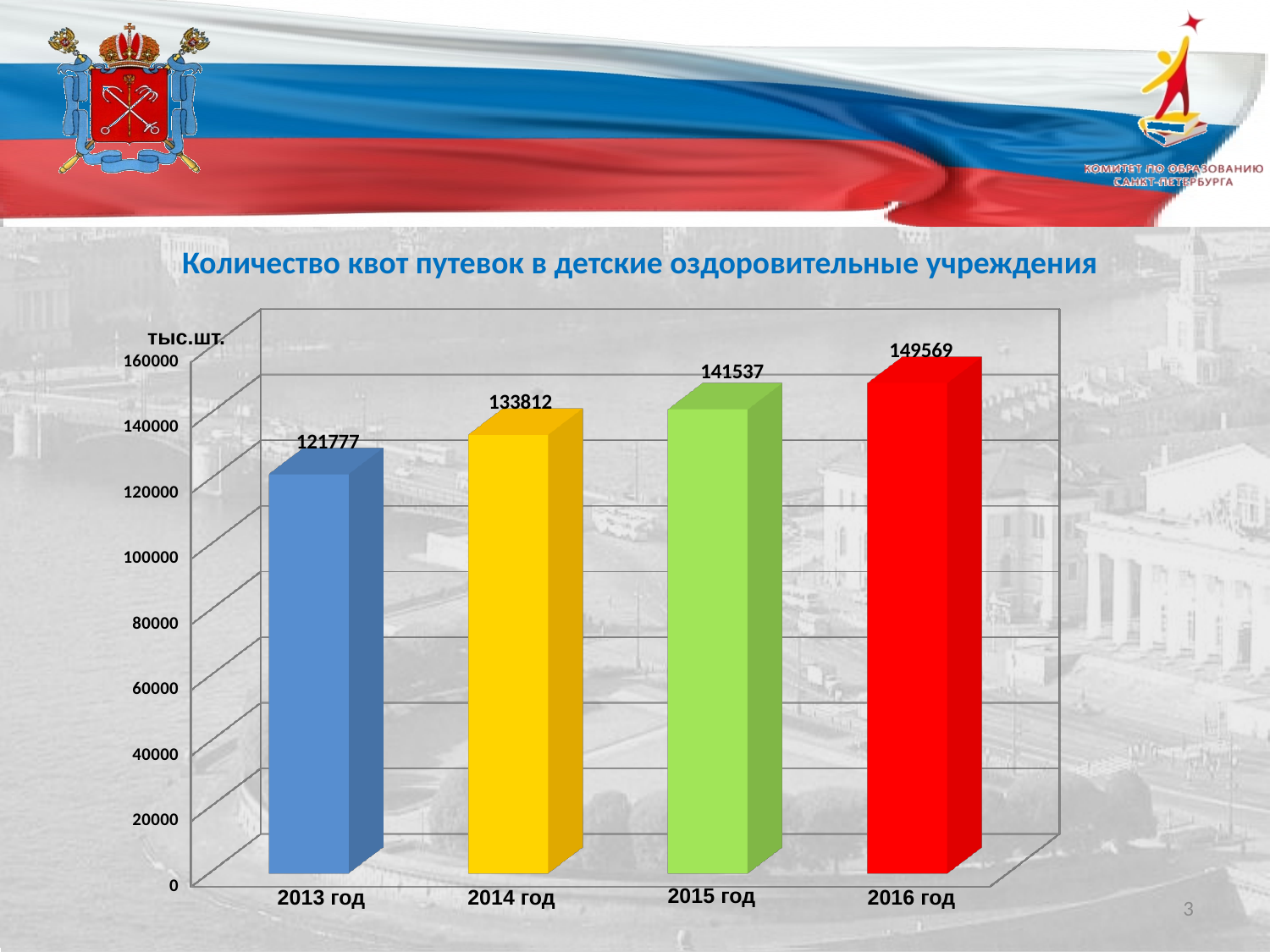
What is the value for 2013 год? 121777 Do the values rise or fall from 2013 год to 2016 год? rise What is the difference between the values for 2016 год and 2013 год? 27792 Which year has the lowest value? 2013 год Which is larger, the value for 2014 год or the value for 2015 год? 2015 год What is the value for 2016 год? 149569 Which year has the highest value? 2016 год Is the value for 2013 год greater or less than 120000? greater What is the value for 2014 год? 133812 How many years are shown on the x axis? 4 What is the value for 2015 год? 141537 What kind of chart is shown on the slide? bar chart